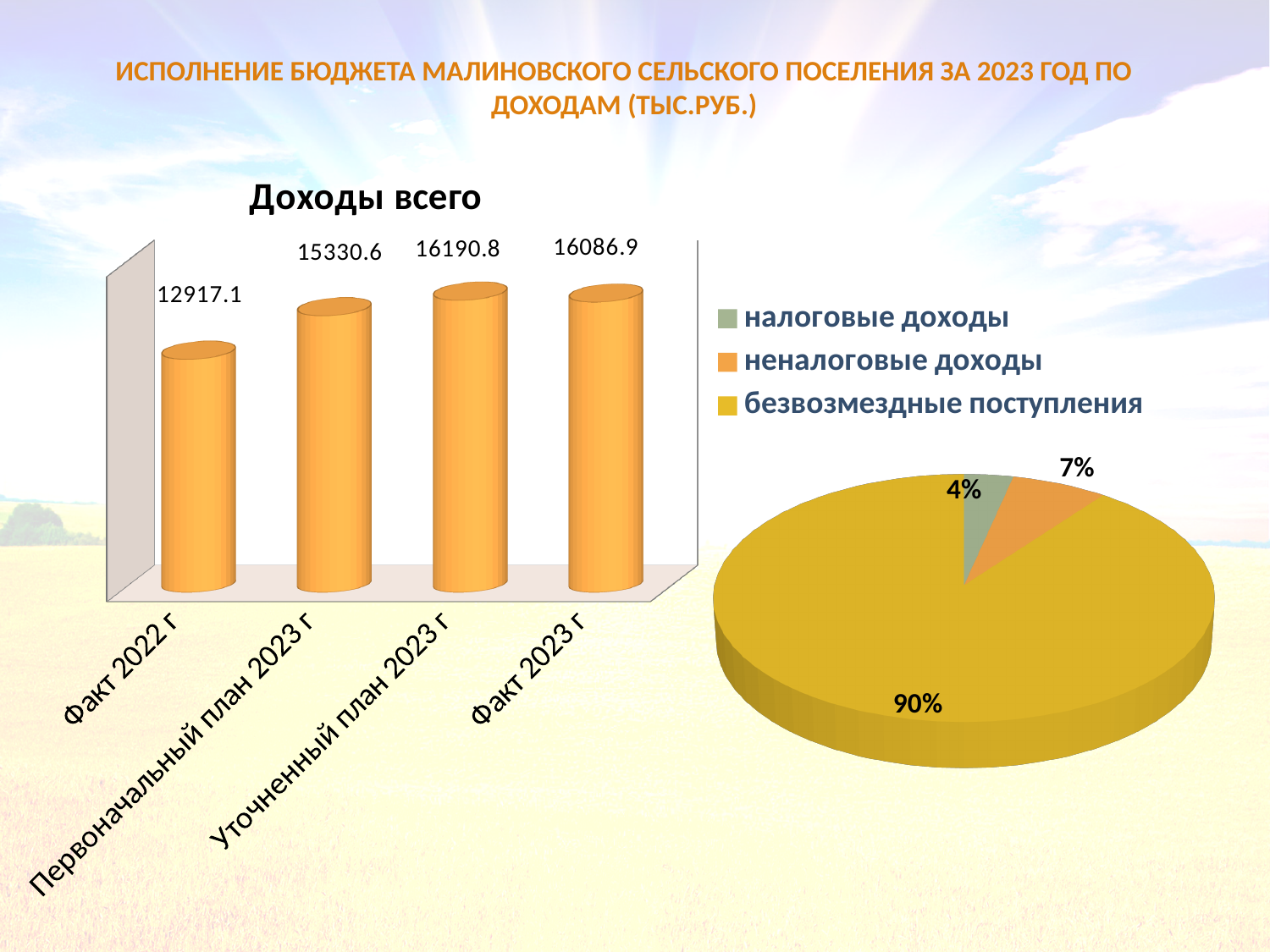
What type of chart is the 'Доходы всего' chart on the left? Bar chart In the 'Доходы всего' bar chart, what is the value for 'Факт 2023 г'? 16086.9 In the pie chart on the right, what share does 'налоговые доходы' have? 4% In the 'Доходы всего' bar chart, which is larger: 'Первоначальный план 2023 г' or 'Факт 2023 г'? Факт 2023 г In the pie chart on the right, what share does 'безвозмездные поступления' have? 90% How many entries does the legend of the pie chart on the right list? 3 In the 'Доходы всего' bar chart, what is the value for 'Уточненный план 2023 г'? 16190.8 In the 'Доходы всего' bar chart, what is the difference between 'Факт 2023 г' and 'Факт 2022 г'? 3169.8 In the 'Доходы всего' bar chart, which category has the highest value? Уточненный план 2023 г In the 'Доходы всего' bar chart, what is the value for 'Факт 2022 г'? 12917.1 In the 'Доходы всего' bar chart, which category has the lowest value? Факт 2022 г How many categories are shown in the 'Доходы всего' bar chart? 4